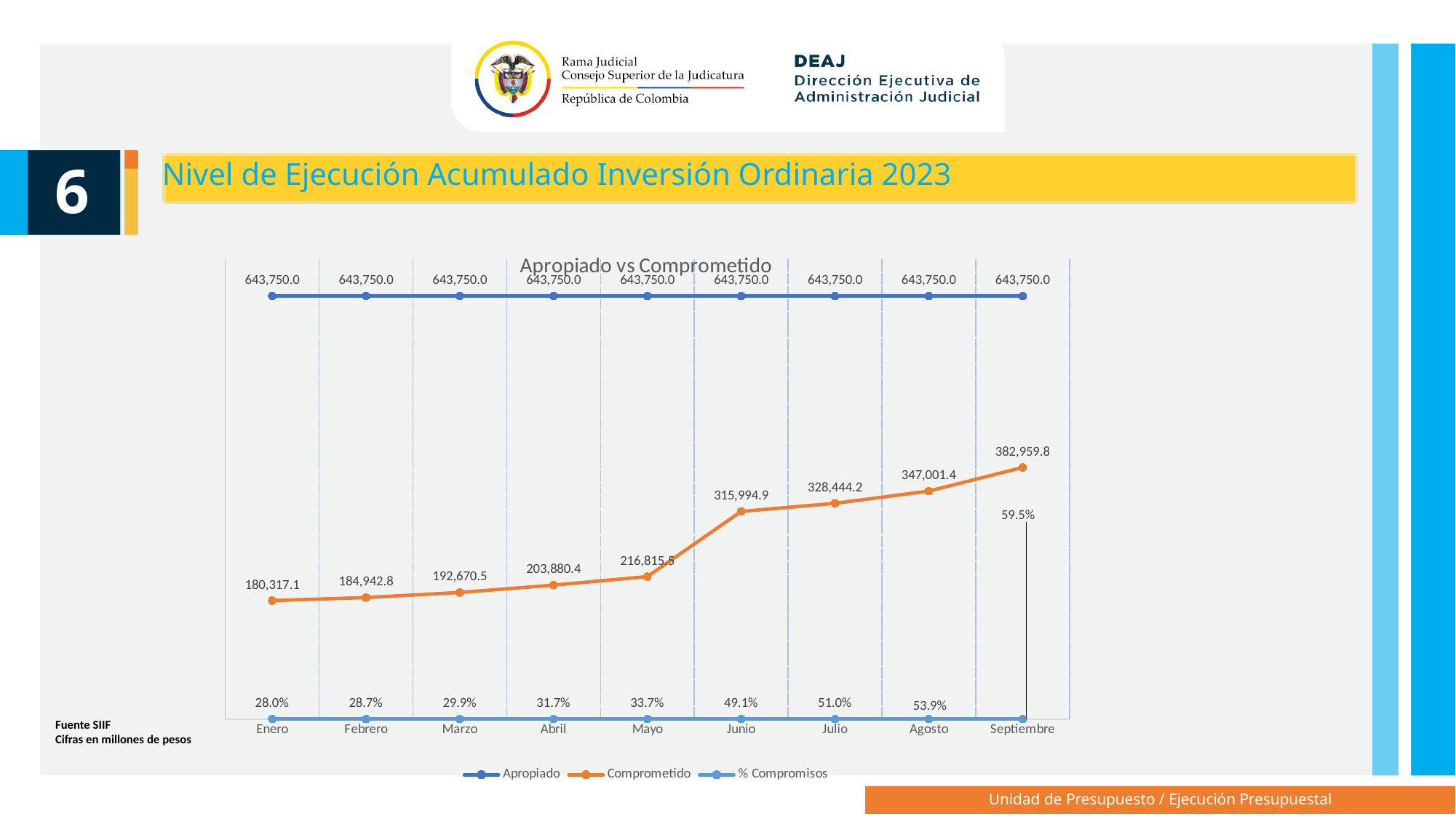
Which month has the highest Comprometido value? Septiembre Which month has the lowest Comprometido value? Enero How many months are shown on the x axis? 9 How many series does the legend list? 3 Does the Comprometido series rise or fall from Enero to Septiembre? Rise Which is larger, the Comprometido value for Mayo or for Junio? Junio What kind of chart is shown on the slide? Line chart What is the % Compromisos value for Septiembre? 59.5% What is the Comprometido value for Junio? 315,994.9 What is the difference between the Comprometido values for Septiembre and Agosto? 35,958.4 What is the Apropiado value for Marzo? 643,750.0 What is the title of the chart? Apropiado vs Comprometido